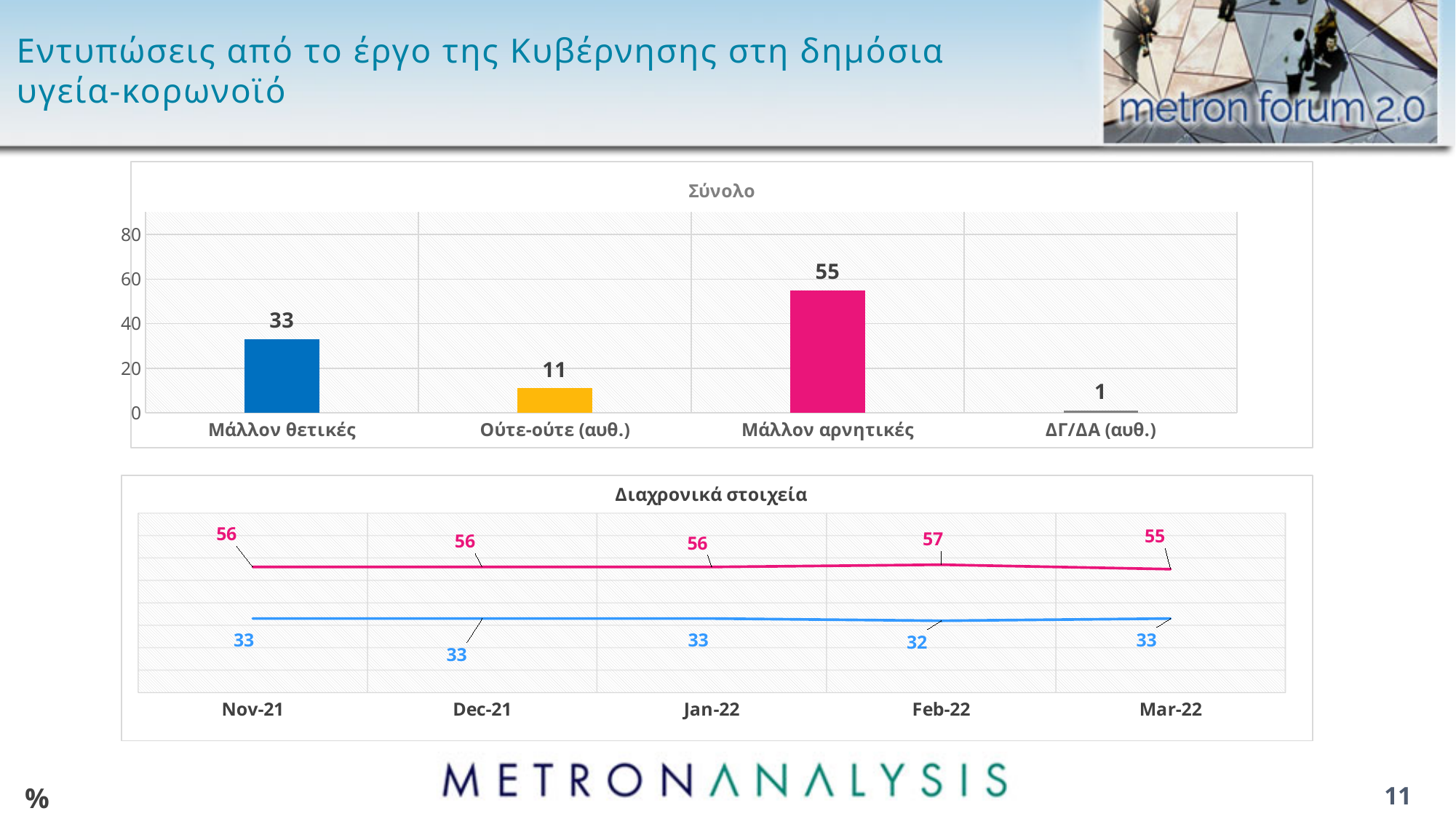
In the 'Διαχρονικά στοιχεία' chart, which is larger in Mar-22: the pink line or the blue line? the pink line In the 'Σύνολο' chart, which category has the lowest value? ΔΓ/ΔΑ (αυθ.) In the 'Σύνολο' chart, which category has the highest value? Μάλλον αρνητικές In the 'Σύνολο' chart, how many categories are shown? 4 In the 'Σύνολο' chart, what is the value for 'Μάλλον αρνητικές'? 55 In the 'Διαχρονικά στοιχεία' chart, what is the value of the pink line for Feb-22? 57 In the 'Σύνολο' chart, what is the difference between 'Μάλλον αρνητικές' and 'Μάλλον θετικές'? 22 In the 'Διαχρονικά στοιχεία' chart, what is the value of the blue line for Feb-22? 32 What kind of chart is the 'Διαχρονικά στοιχεία' chart? line chart In the 'Διαχρονικά στοιχεία' chart, how many time points are plotted? 5 What kind of chart is the 'Σύνολο' chart? bar chart In the 'Σύνολο' chart, what is the value for 'Ούτε-ούτε (αυθ.)'? 11